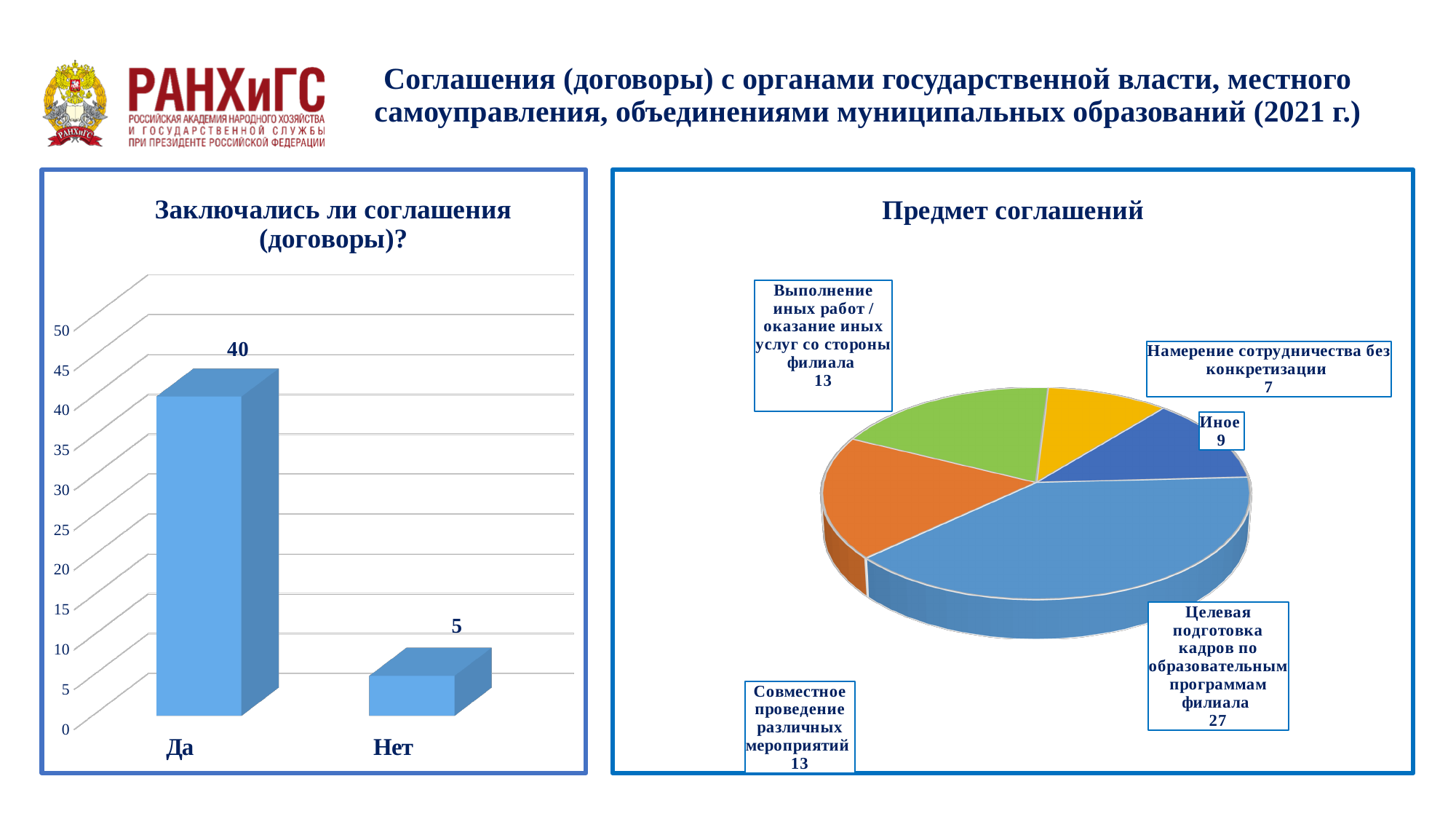
In the chart "Заключались ли соглашения (договоры)?", which category has the higher value? Да In the chart "Предмет соглашений", which is larger: "Иное" or "Совместное проведение различных мероприятий"? Совместное проведение различных мероприятий In the chart "Предмет соглашений", what is the value for "Целевая подготовка кадров по образовательным программам филиала"? 27 In the chart "Предмет соглашений", what is the value for "Намерение сотрудничества без конкретизации"? 7 In the chart "Предмет соглашений", how many categories (slices) are shown? 5 In the chart "Предмет соглашений", what is the value for "Иное"? 9 What kind of chart is "Предмет соглашений"? Pie chart What kind of chart is "Заключались ли соглашения (договоры)?"? Bar chart In the chart "Заключались ли соглашения (договоры)?", what is the value for "Да"? 40 In the chart "Заключались ли соглашения (договоры)?", what is the value for "Нет"? 5 In the chart "Заключались ли соглашения (договоры)?", what is the difference between the values for "Да" and "Нет"? 35 In the chart "Предмет соглашений", which category has the smallest value? Намерение сотрудничества без конкретизации